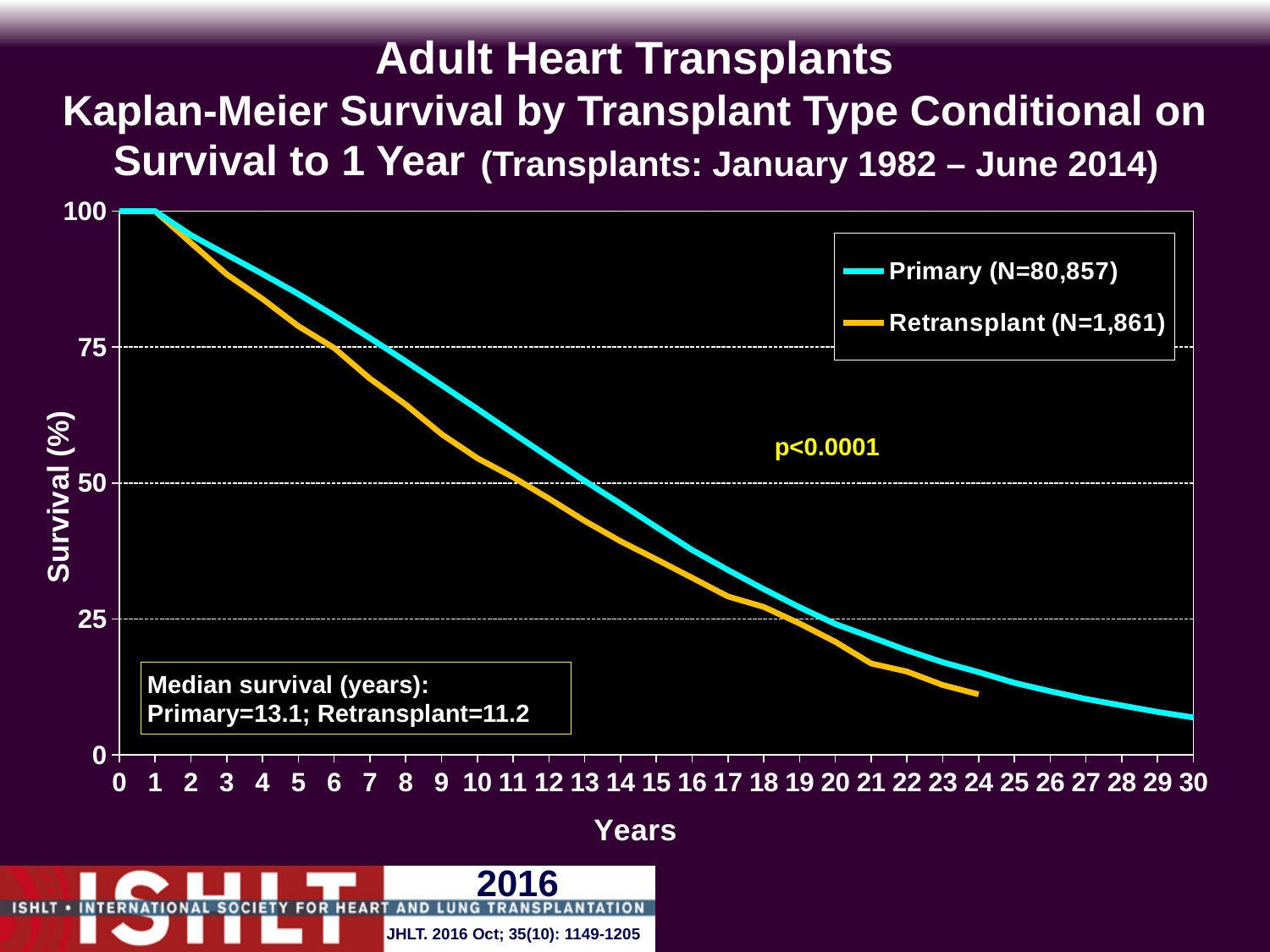
What is the N for the Primary series shown in the legend? 80,857 At 10 years, which series has the higher survival, Primary or Retransplant? Primary What is the difference in median survival (years) between Primary and Retransplant? 1.9 Do the survival curves rise or fall as years increase? Fall What is the median survival in years for Retransplants? 11.2 Is the Primary survival at 10 years greater or less than 50%? greater What are the two series named in the legend? Primary and Retransplant What is the N for the Retransplant series shown in the legend? 1,861 What kind of chart is shown on the slide? Line chart Is the Primary survival at 30 years greater or less than 25%? less What is the median survival in years for Primary transplants? 13.1 How many series does the legend list? 2